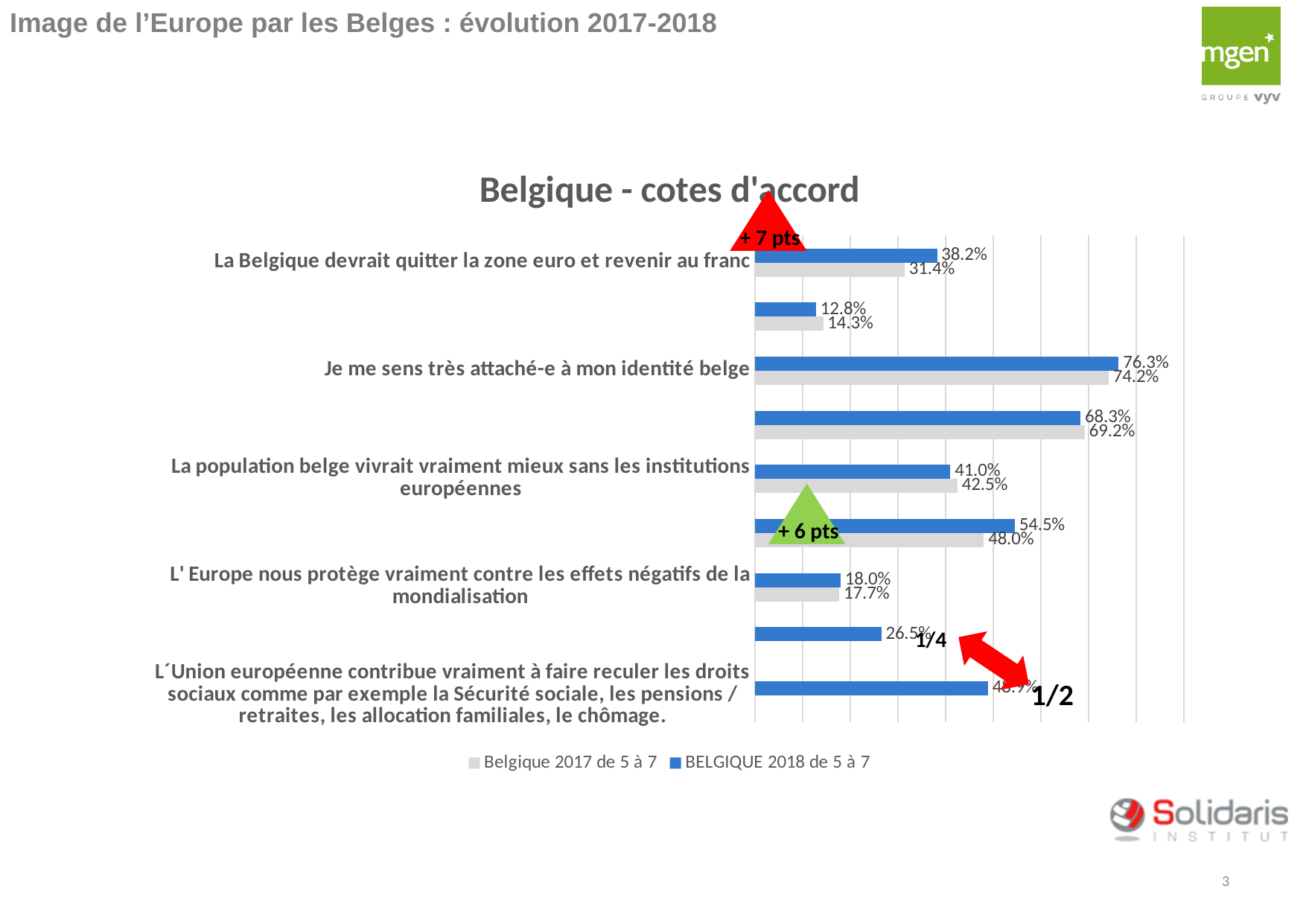
What is the value of the BELGIQUE 2018 de 5 à 7 series for "La Belgique devrait quitter la zone euro et revenir au franc"? 38.2% How many series does the chart legend list? 2 What is the 2017 value for "L' Europe nous protège vraiment contre les effets négatifs de la mondialisation"? 17.7% What is the value of the Belgique 2017 de 5 à 7 series for "La Belgique devrait quitter la zone euro et revenir au franc"? 31.4% Which statement has the highest 2018 value in the chart? Je me sens très attaché-e à mon identité belge What is the 2018 value for "Je me sens très attaché-e à mon identité belge"? 76.3% By how many percentage points did agreement with "La Belgique devrait quitter la zone euro et revenir au franc" change from 2017 (31.4%) to 2018 (38.2%)? 6.8 percentage points What is the 2017 value for "Je me sens très attaché-e à mon identité belge"? 74.2% What is the 2018 value for "La population belge vivrait vraiment mieux sans les institutions européennes"? 41.0% For "La population belge vivrait vraiment mieux sans les institutions européennes", which year has the higher value, 2017 or 2018? 2017 What is the title of the chart? Belgique - cotes d'accord What type of chart is shown on the slide? Bar chart